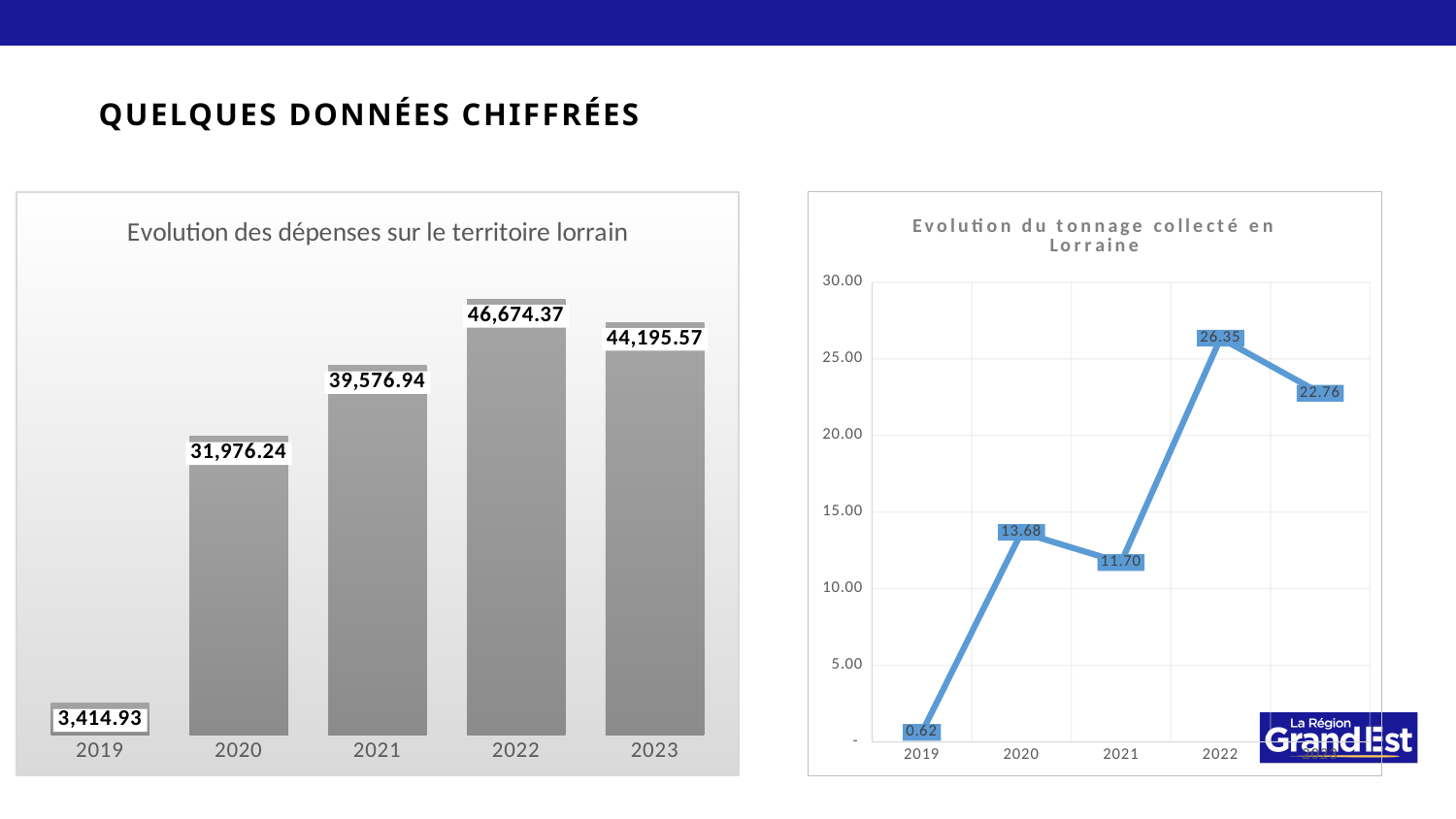
In the chart 'Evolution des dépenses sur le territoire lorrain', what is the difference between the 2022 and 2023 values? 2,478.80 In the chart 'Evolution des dépenses sur le territoire lorrain', what is the value for 2021? 39,576.94 In the chart 'Evolution des dépenses sur le territoire lorrain', which year has the highest value? 2022 In the chart 'Evolution des dépenses sur le territoire lorrain', how many years are shown on the x axis? 5 What kind of chart is 'Evolution du tonnage collecté en Lorraine'? line chart In the chart 'Evolution du tonnage collecté en Lorraine', what is the value for 2022? 26.35 In the chart 'Evolution des dépenses sur le territoire lorrain', what is the value for 2019? 3,414.93 What kind of chart is 'Evolution des dépenses sur le territoire lorrain'? bar chart In the chart 'Evolution du tonnage collecté en Lorraine', what is the value for 2020? 13.68 In the chart 'Evolution des dépenses sur le territoire lorrain', which year has the lowest value? 2019 In the chart 'Evolution du tonnage collecté en Lorraine', which year has the lowest value? 2019 In the chart 'Evolution du tonnage collecté en Lorraine', is the value for 2021 larger or smaller than the value for 2020? smaller